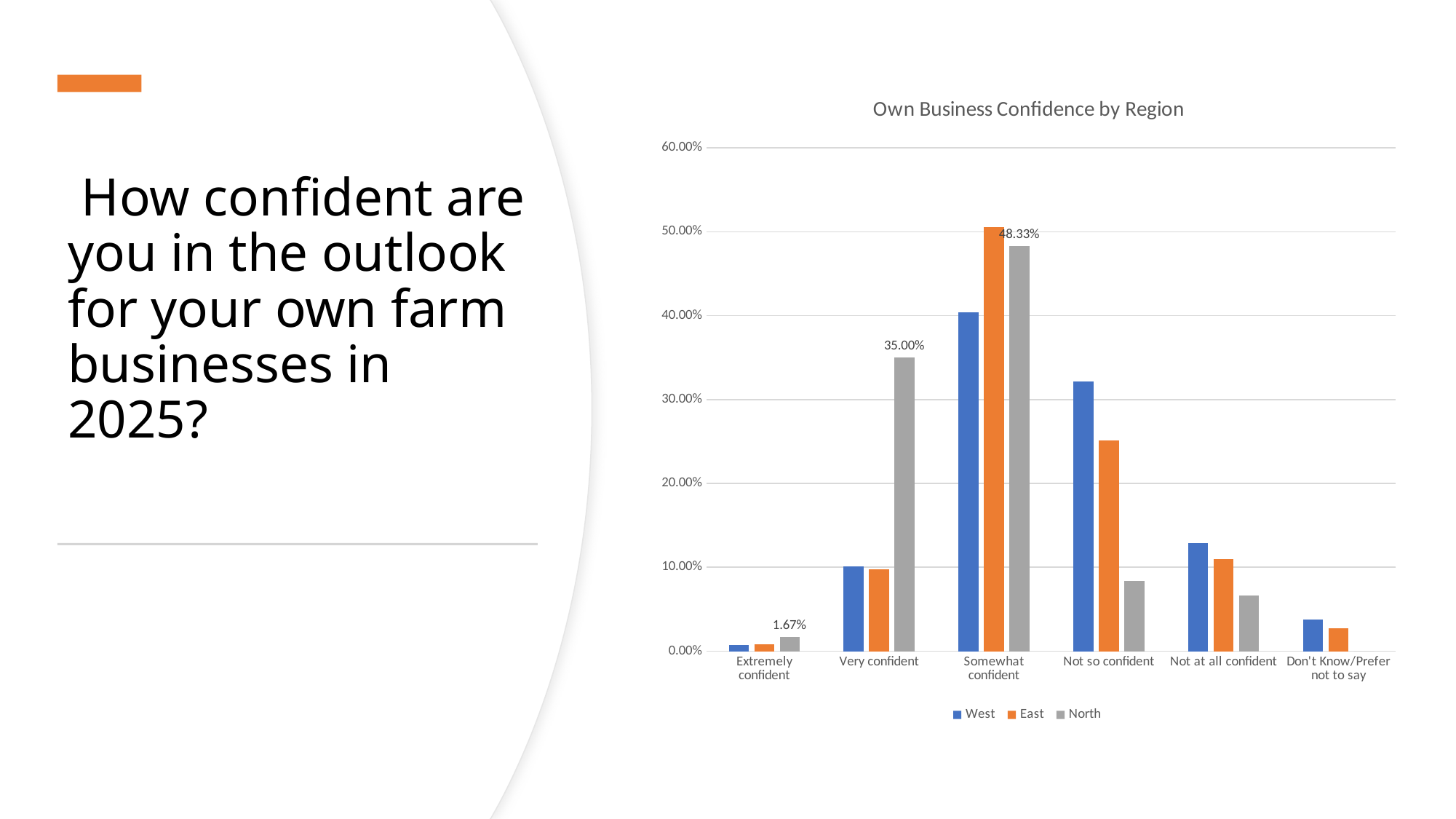
What is the difference between the North values for Somewhat confident and Very confident? 13.33% What is the value for North in the Very confident category? 35.00% What is the value for North in the Somewhat confident category? 48.33% How many series does the chart legend list? 3 How many categories are shown on the x axis of the chart? 6 Which category has the highest value for the North series? Somewhat confident Is the value for West in the Not so confident category greater or less than 30.00%? greater What is the title of the chart? Own Business Confidence by Region What is the value for North in the Extremely confident category? 1.67% What kind of chart is shown on the slide? bar chart Which is larger in the Not so confident category, West or North? West